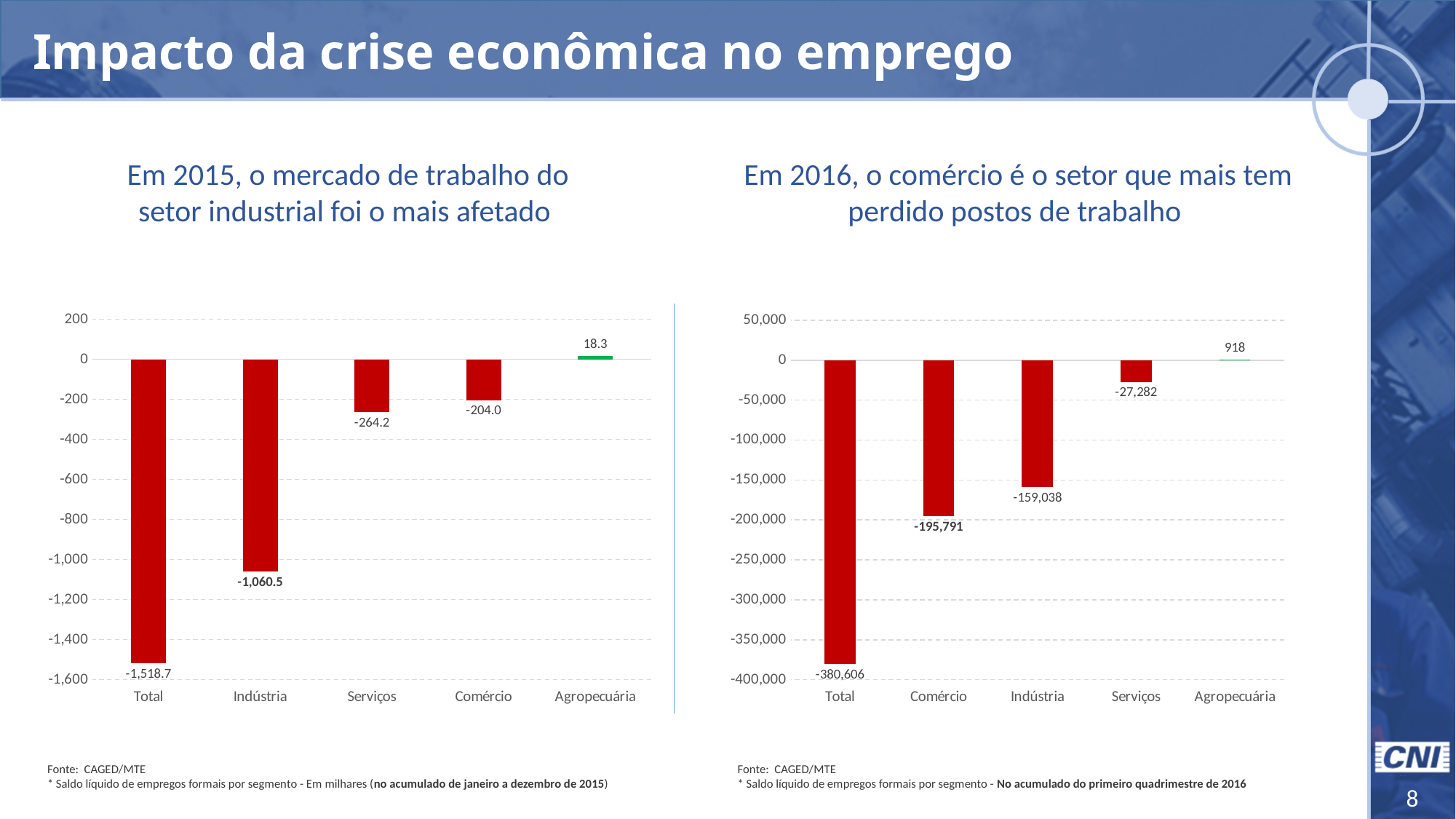
In the right chart (2016), what is the value for Serviços? -27,282 In the left chart (2015), what is the difference between the values for Serviços and Comércio? 60.2 In the right chart (2016), what is the value for Comércio? -195,791 What type of chart is the right chart (2016)? Bar chart In the left chart (2015), what is the value for Agropecuária? 18.3 In the right chart (2016), which is larger, the value for Indústria or the value for Serviços? Serviços How many categories are shown in the left chart (2015)? 5 In the right chart (2016), which category has the highest value? Agropecuária In the left chart (2015), what is the value for Indústria? -1,060.5 In the right chart (2016), what is the difference between the values for Comércio and Indústria? 36,753 In the left chart (2015), which category has the lowest value? Total In the left chart (2015), what colour is the bar for Agropecuária? Green